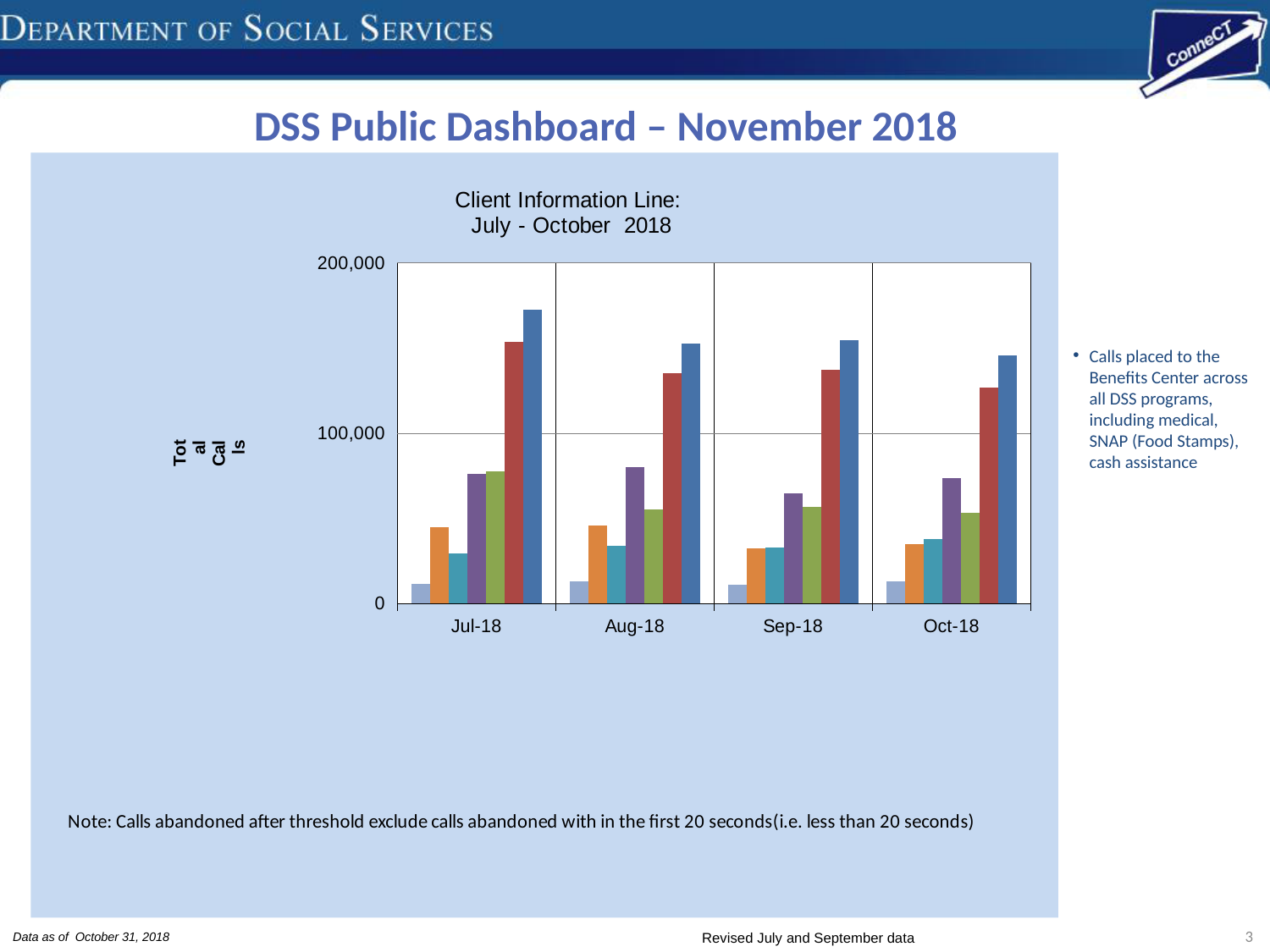
Which month contains the tallest bar in the chart? Jul-18 Is the tallest bar for Jul-18 greater or less than 100,000? greater Is the purple bar for Aug-18 greater or less than 100,000? less What is the title of the chart? Client Information Line: July - October 2018 How many months are shown on the x axis of the chart? 4 How many bars are plotted for each month in the chart? 7 Is the dark blue bar for Oct-18 greater or less than 100,000? greater What is the highest value shown on the y axis of the chart? 200,000 What kind of chart is shown on the slide? bar chart In Jul-18, which is taller: the dark blue bar or the red bar? the dark blue bar